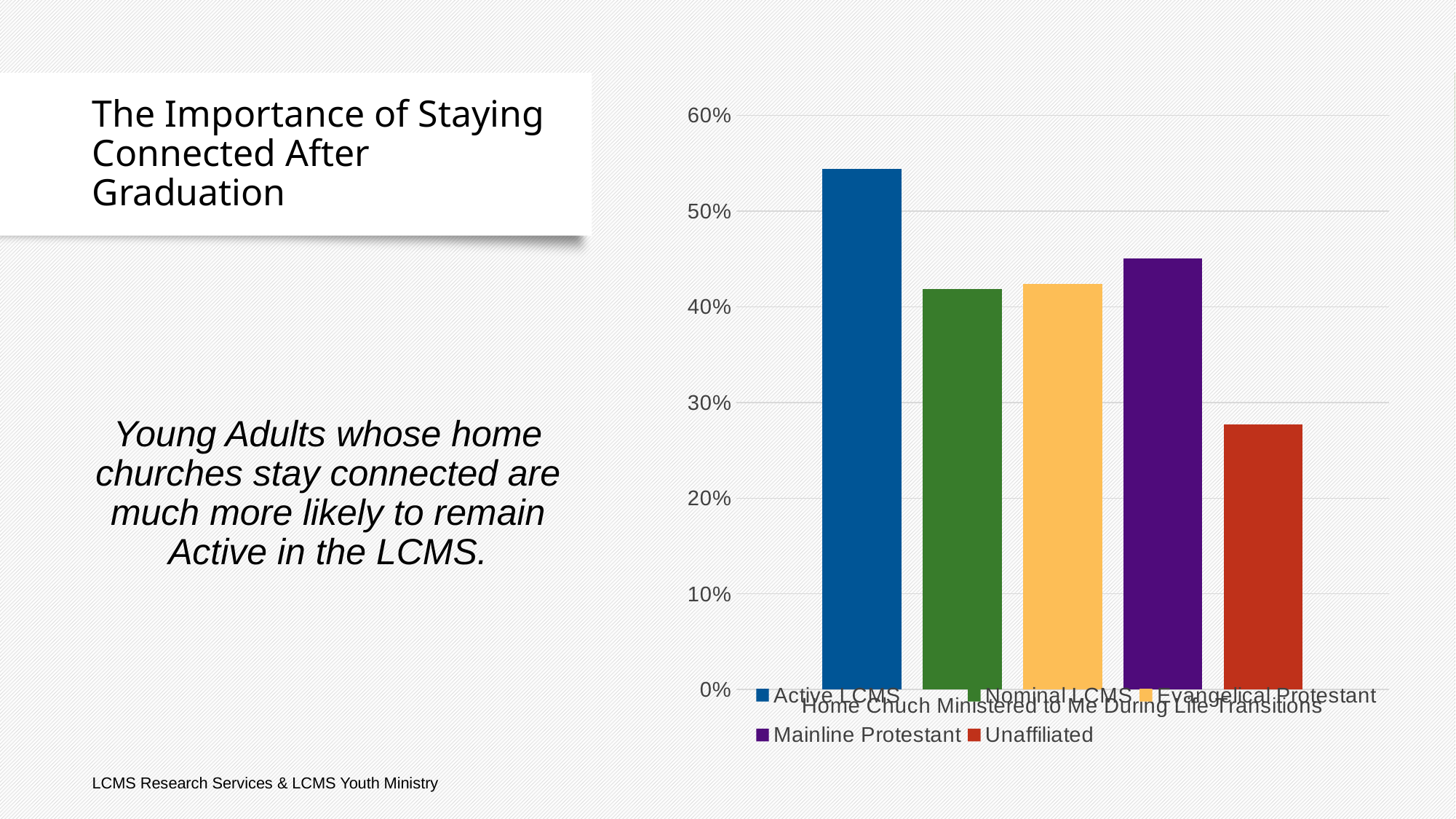
Is the value for Mainline Protestant greater or less than 40%? greater Is the value for Unaffiliated greater or less than 20%? greater What colour is the bar for Unaffiliated in the chart? red What kind of chart is shown on the slide? bar chart What is the category label shown on the x axis of the chart? Home Chuch Ministered to Me During Life Transitions Which is larger, the value for Mainline Protestant or the value for Unaffiliated? Mainline Protestant Which series has the lowest bar in the chart? Unaffiliated How many series does the chart's legend list? 5 Which is larger, the value for Active LCMS or the value for Mainline Protestant? Active LCMS Is the value for Active LCMS greater or less than 50%? greater Which series has the highest bar in the chart? Active LCMS